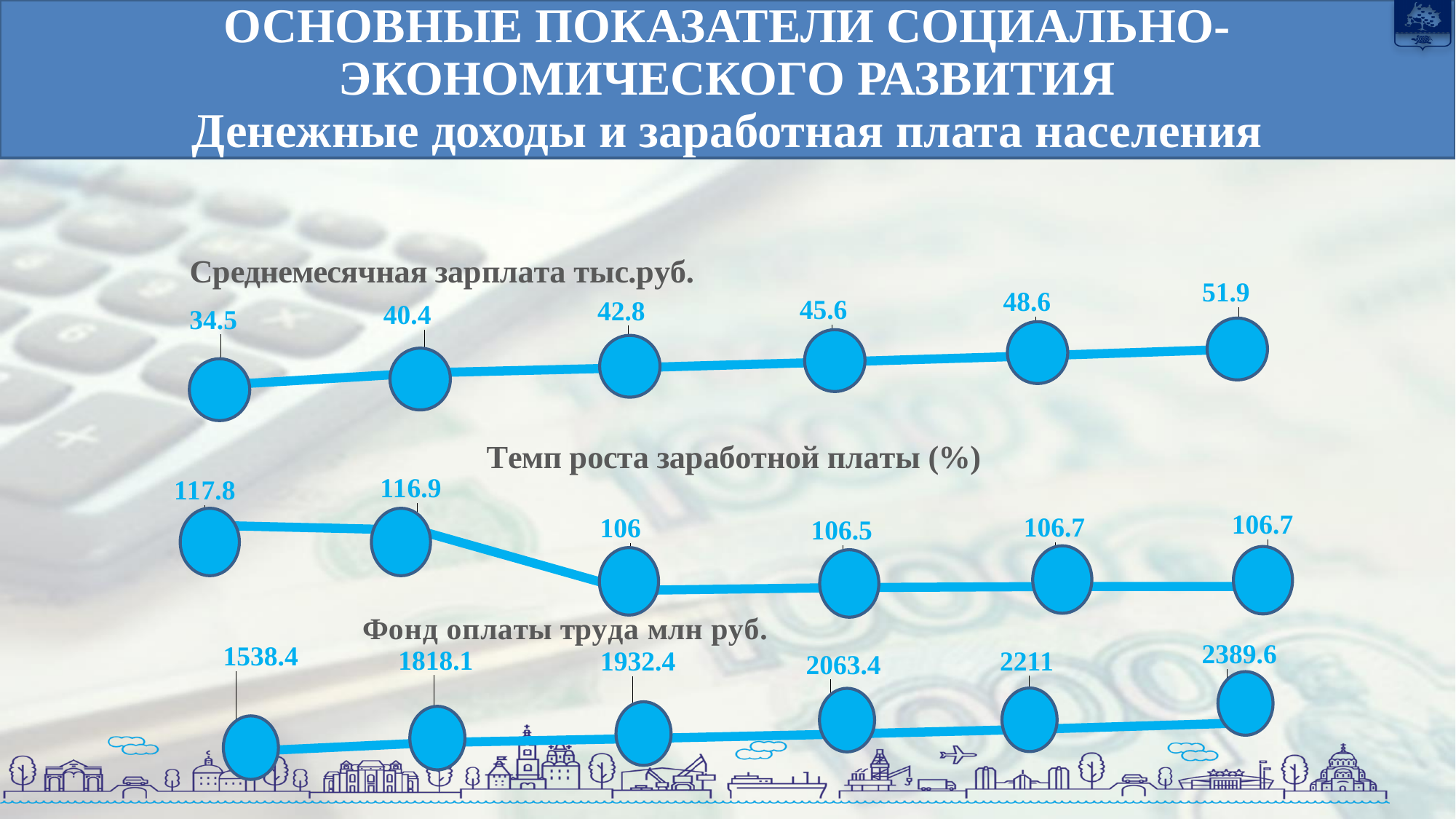
What type of chart is the chart titled "Фонд оплаты труда млн руб."? line chart In the chart titled "Фонд оплаты труда млн руб.", which is larger, the second point or the third point? the third point (1932.4) In the chart titled "Среднемесячная зарплата тыс.руб.", what is the difference between the last and the first point? 17.4 In the chart titled "Среднемесячная зарплата тыс.руб.", do the values rise or fall from left to right? rise In the chart titled "Темп роста заработной платы (%)", how many data points are plotted? 6 In the chart titled "Фонд оплаты труда млн руб.", what is the value of the fifth point? 2211 In the chart titled "Фонд оплаты труда млн руб.", what is the difference between the last point and the first point? 851.2 In the chart titled "Среднемесячная зарплата тыс.руб.", what is the value of the first point? 34.5 In the chart titled "Темп роста заработной платы (%)", which point has the lowest value? the third point (106) In the chart titled "Темп роста заработной платы (%)", which point has the highest value? the first point (117.8) In the chart titled "Среднемесячная зарплата тыс.руб.", what is the value of the last point? 51.9 In the chart titled "Темп роста заработной платы (%)", what is the value of the second point? 116.9